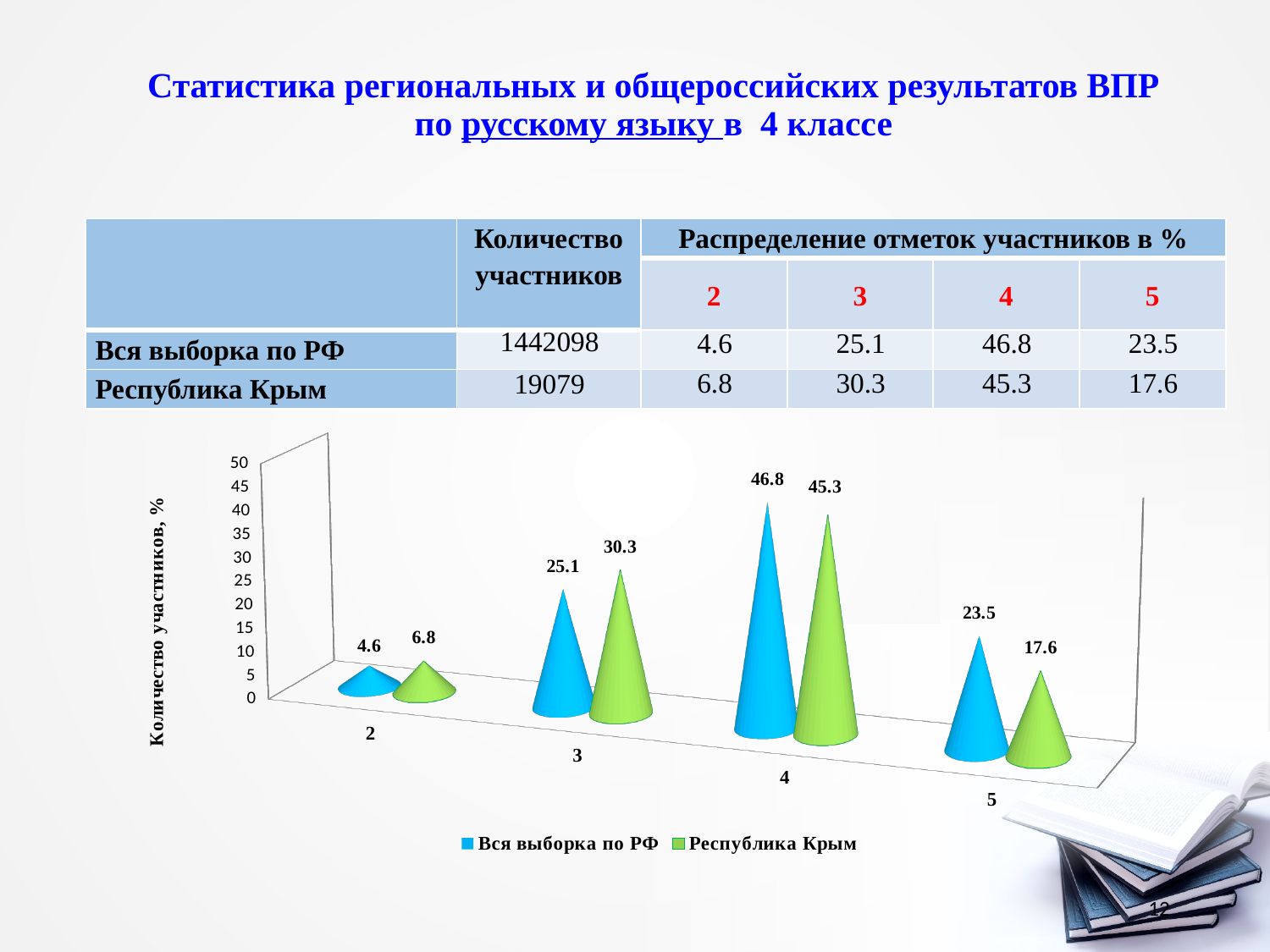
For which mark is the value for "Вся выборка по РФ" highest? 4 What is the value for "Республика Крым" at mark 3? 30.3 How many series does the chart legend list? 2 What is the difference between the values for "Вся выборка по РФ" and "Республика Крым" at mark 5? 5.9 What is the label of the vertical axis of the chart? Количество участников, % Is the value for "Вся выборка по РФ" at mark 2 greater or less than 10? less How many marks (categories) are shown on the x axis of the chart? 4 What kind of chart is shown on the slide? bar chart What is the value for "Вся выборка по РФ" at mark 4? 46.8 What is the value for "Республика Крым" at mark 5? 17.6 Which series has the larger value at mark 3, "Вся выборка по РФ" or "Республика Крым"? Республика Крым For which mark is the value for "Республика Крым" lowest? 2